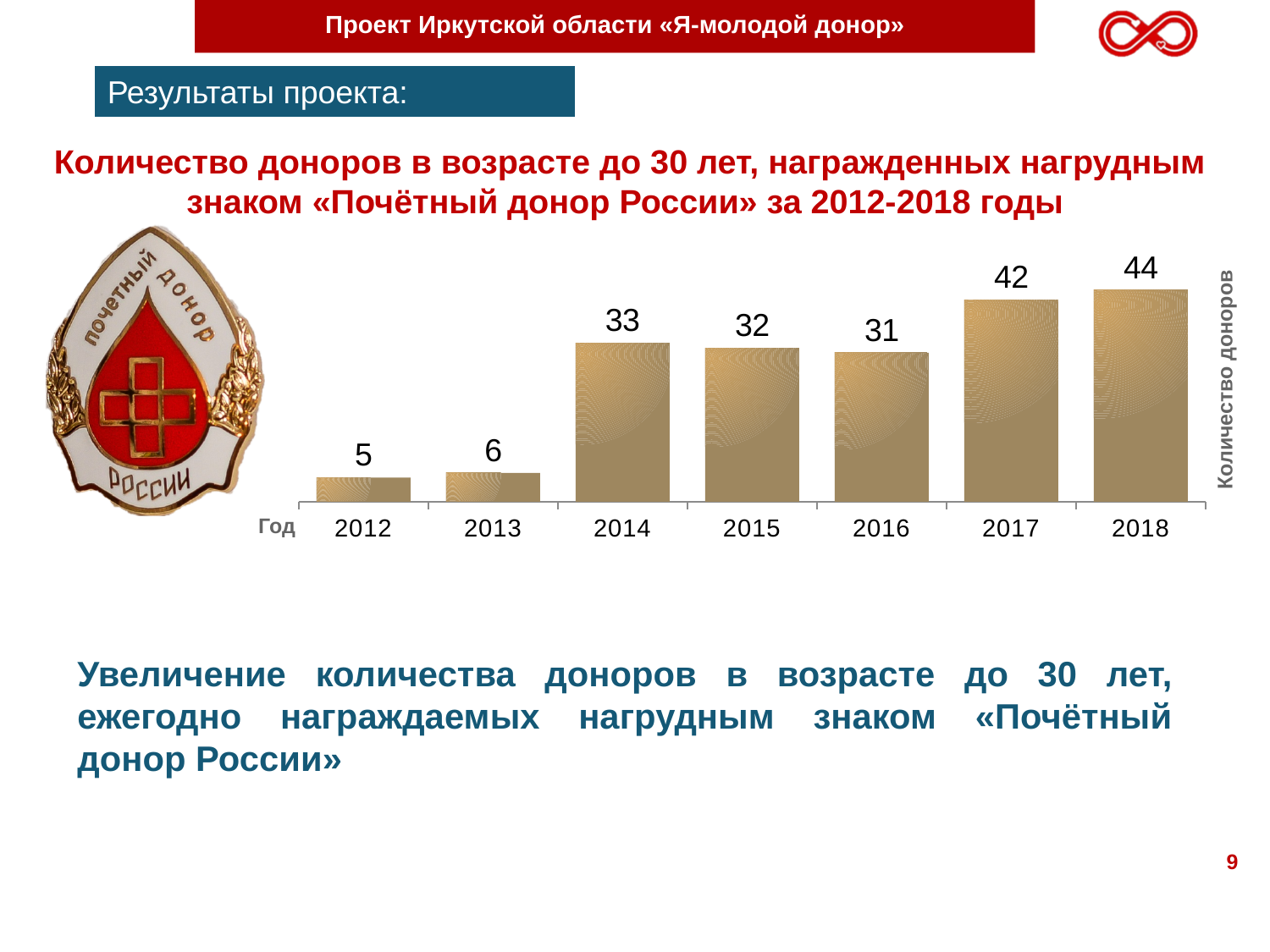
Which year has the lowest value? 2012 What is the difference between the values for 2018 and 2012? 39 How many years are shown on the x axis? 7 What kind of chart is this? bar chart What is the label of the x axis? Год Which year has the highest value? 2018 Which is larger, the value for 2015 or the value for 2017? 2017 What is the value for 2018? 44 Do the values generally rise or fall from 2012 to 2018? rise What is the value for 2012? 5 What is the difference between the values for 2014 and 2013? 27 What is the value for 2016? 31